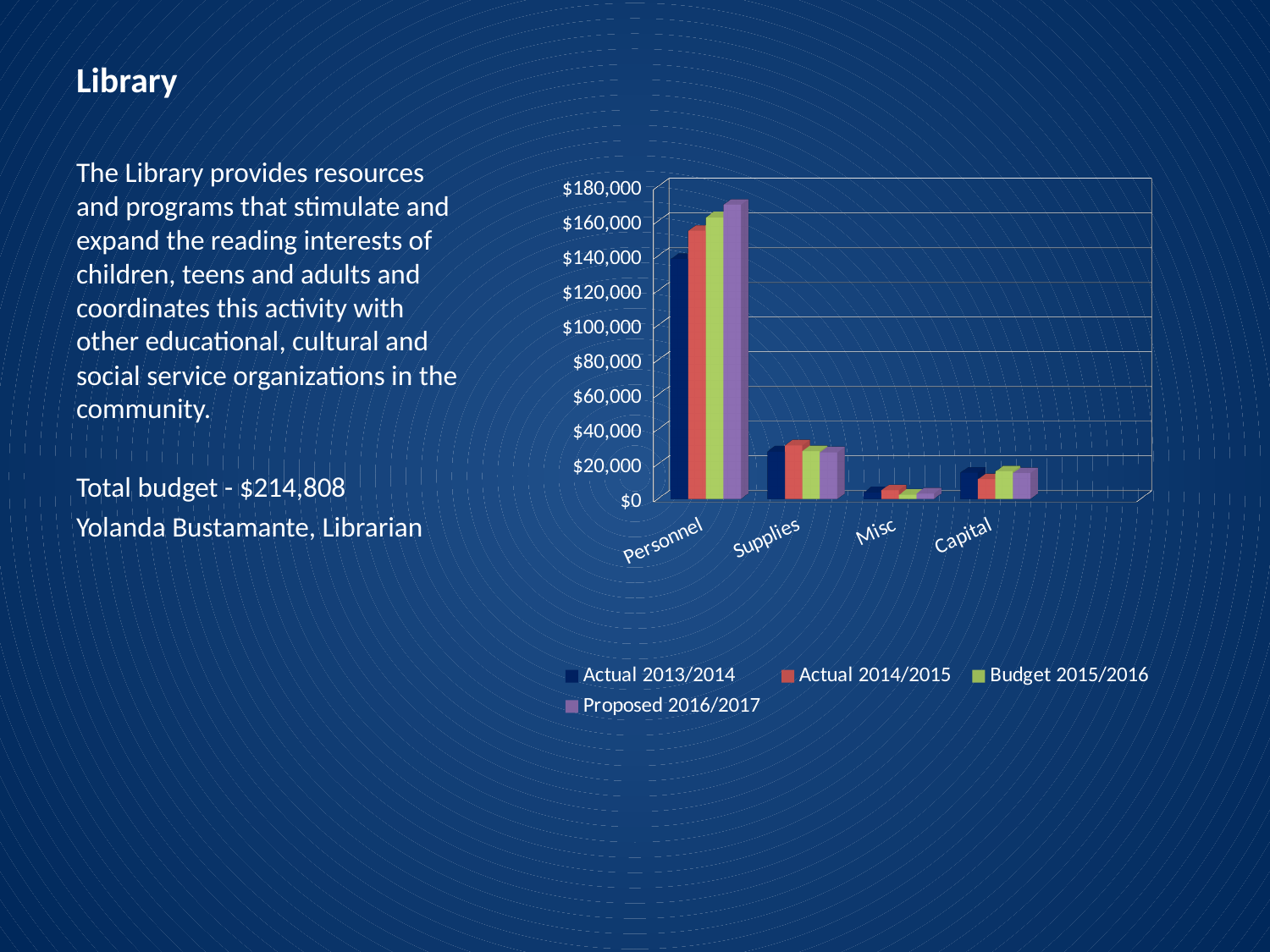
Is the Budget 2015/2016 value for Capital greater or less than $40,000? less Which category has the lowest values in the chart? Misc Is the Actual 2013/2014 value for Personnel greater or less than $160,000? less Within the Personnel category, do the bars rise or fall from Actual 2013/2014 to Proposed 2016/2017? rise What kind of chart is shown on the slide? bar chart How many series does the chart's legend list? 4 Which series is shown in purple in the chart's legend? Proposed 2016/2017 Which category has the highest values in the chart? Personnel How many categories are shown on the x axis of the chart? 4 Which category has larger values, Personnel or Supplies? Personnel Is the Proposed 2016/2017 value for Personnel greater or less than $160,000? greater